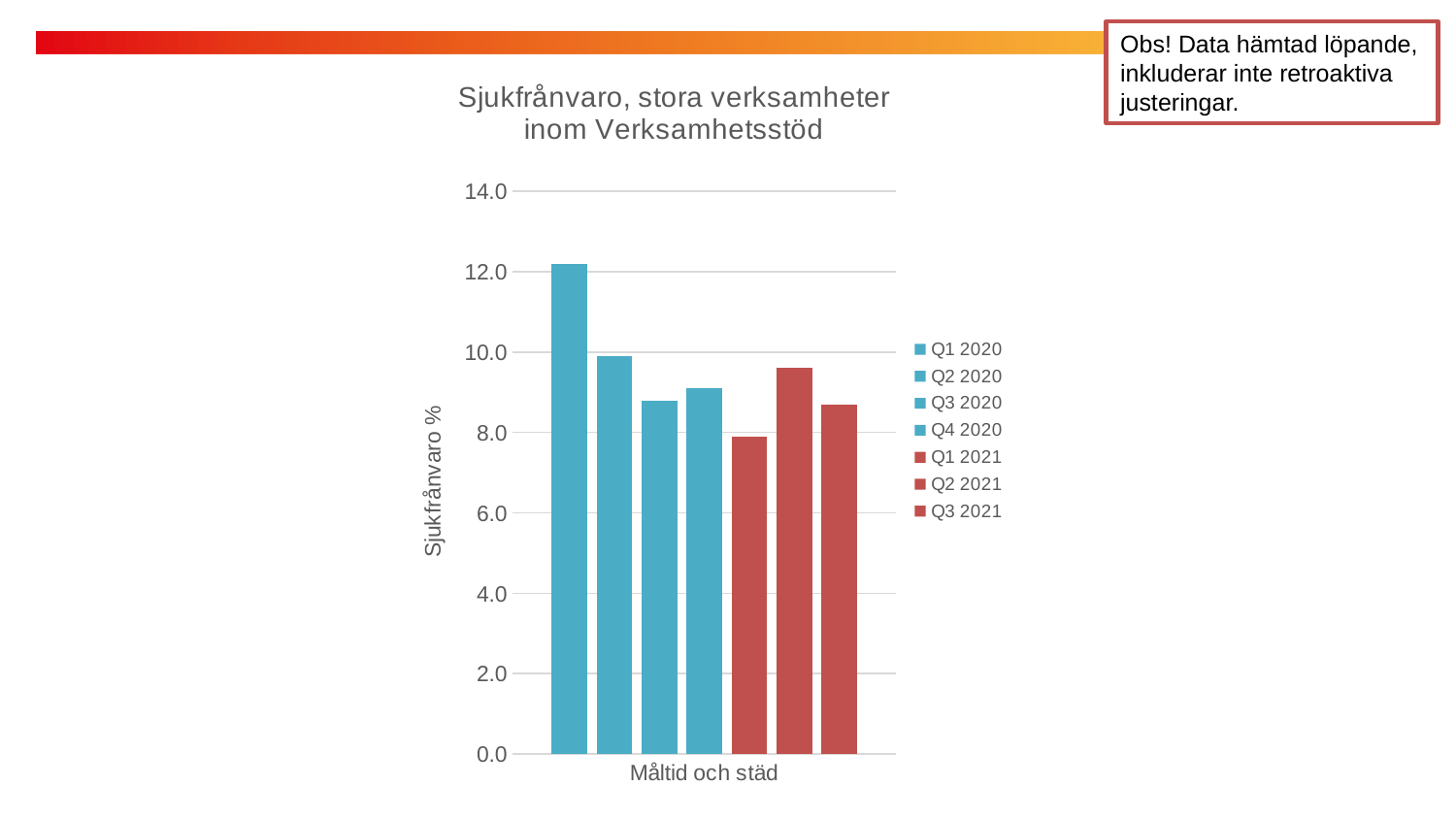
Which quarter has the lowest sick leave value for Måltid och städ? Q1 2021 Which is larger, the value for Q4 2020 or the value for Q1 2021? Q4 2020 What type of chart is shown on the slide? Bar chart Is the value for Q1 2020 greater or less than 10.0? greater How many series does the legend list? 7 What is the title of the chart? Sjukfrånvaro, stora verksamheter inom Verksamhetsstöd What is the label on the x axis category? Måltid och städ Which is larger, the value for Q1 2020 or the value for Q2 2020? Q1 2020 Is the value for Q2 2021 greater or less than 8.0? greater Is the value for Q1 2021 greater or less than 10.0? less Which quarter has the highest sick leave value for Måltid och städ? Q1 2020